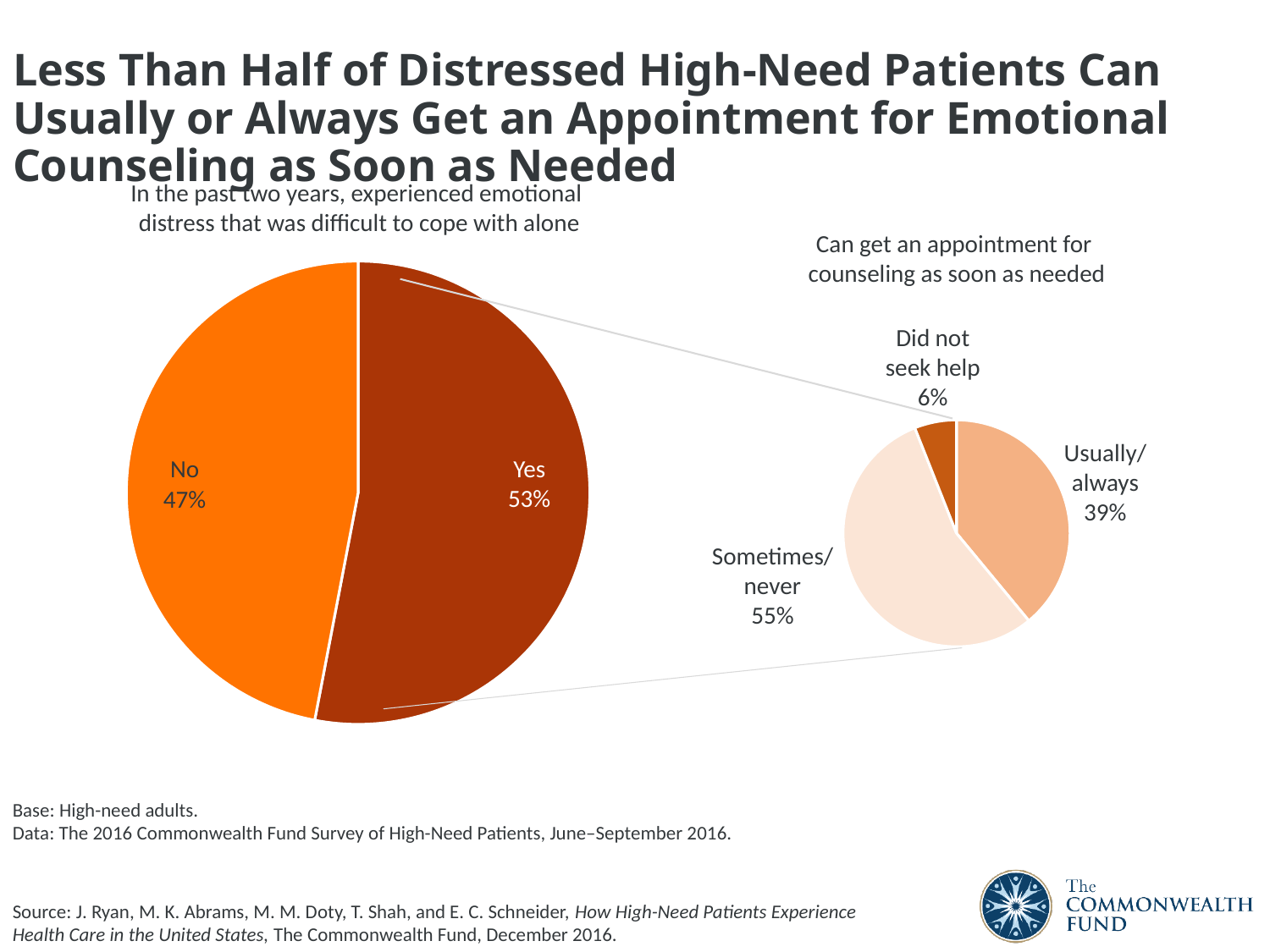
In the right pie chart (can get an appointment for counseling as soon as needed), what percentage did not seek help? 6% In the right pie chart (can get an appointment for counseling as soon as needed), what is the difference between Sometimes/never and Usually/always? 16 percentage points In the right pie chart (can get an appointment for counseling as soon as needed), what percentage is Sometimes/never? 55% How many slices does the right pie chart (can get an appointment for counseling as soon as needed) have? 3 In the left pie chart (experienced emotional distress), which is larger, Yes or No? Yes In the right pie chart (can get an appointment for counseling as soon as needed), which category has the smallest share? Did not seek help In the left pie chart (experienced emotional distress), what is the difference between the Yes and No percentages? 6 percentage points In the left pie chart (experienced emotional distress), what percentage answered No? 47% In the right pie chart (can get an appointment for counseling as soon as needed), which category has the largest share? Sometimes/never In the left pie chart (experienced emotional distress), what percentage answered Yes? 53% In the right pie chart (can get an appointment for counseling as soon as needed), what percentage is Usually/always? 39% What type of chart is used on this slide? Pie chart